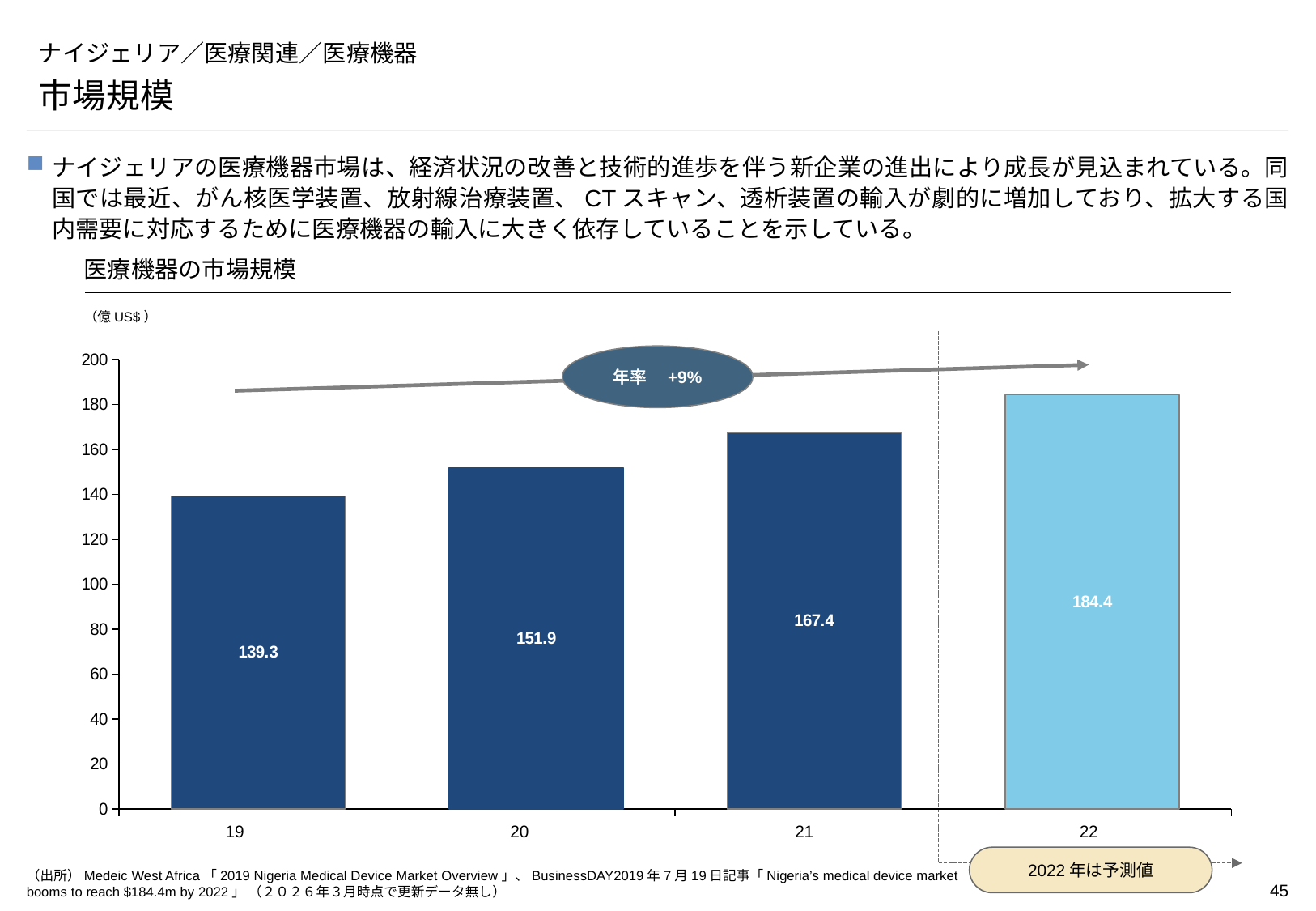
What is the difference between the values for 21 and 20 in the 医療機器の市場規模 chart? 15.5 What is the value for 20 in the 医療機器の市場規模 chart? 151.9 Which year has the highest value in the 医療機器の市場規模 chart? 22 What kind of chart is the 医療機器の市場規模 chart? bar chart Which is larger in the 医療機器の市場規模 chart, the value for 20 or the value for 21? 21 What is the value for 21 in the 医療機器の市場規模 chart? 167.4 Which year has the lowest value in the 医療機器の市場規模 chart? 19 Do the values in the 医療機器の市場規模 chart rise or fall from 19 to 22? rise What is the value for 19 in the 医療機器の市場規模 chart? 139.3 How many bars are plotted in the 医療機器の市場規模 chart? 4 What is the difference between the values for 22 and 19 in the 医療機器の市場規模 chart? 45.1 What is the value for 22 in the 医療機器の市場規模 chart? 184.4